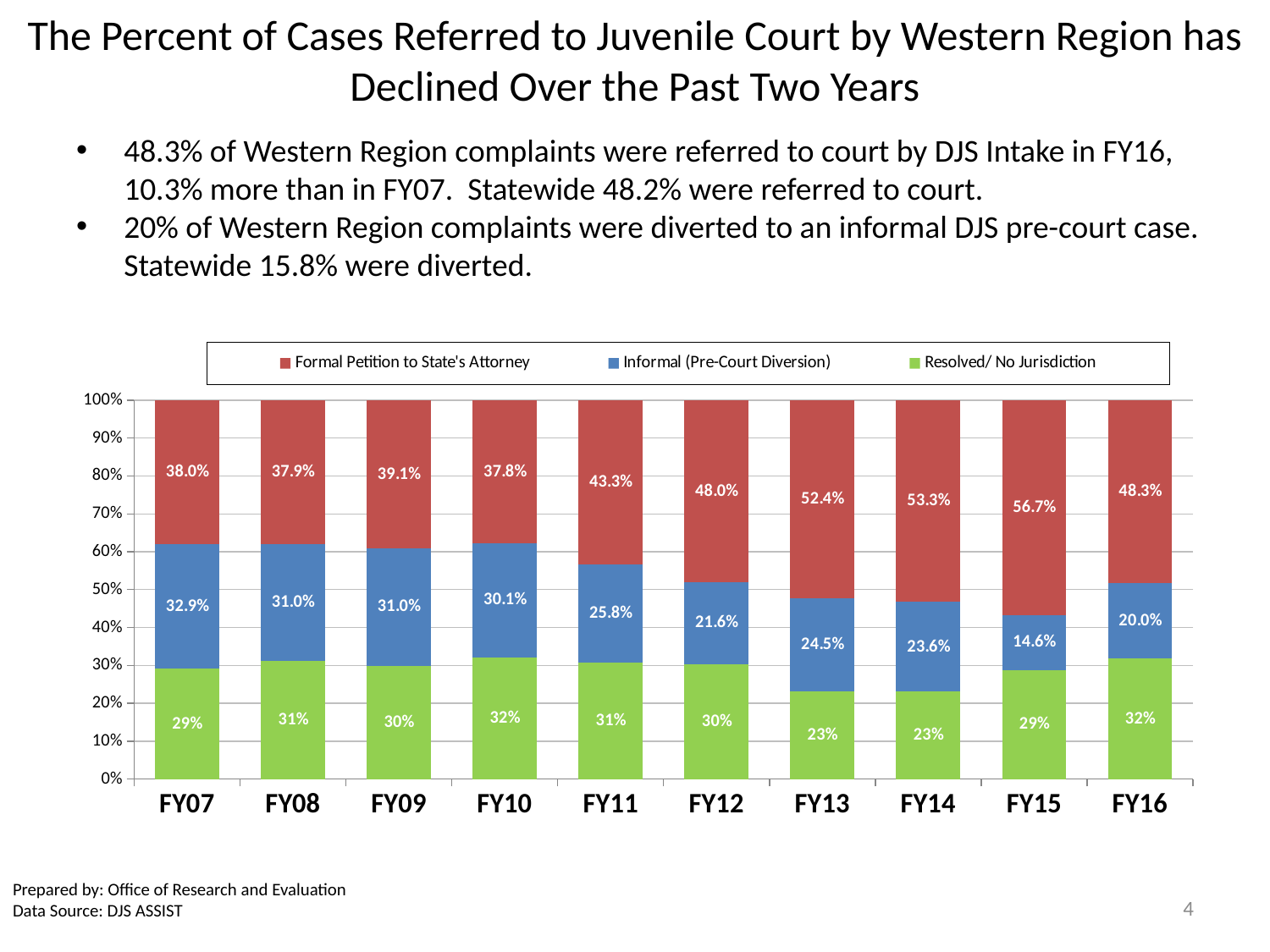
Does the Formal Petition to State's Attorney share rise or fall from FY10 to FY15? Rise In which fiscal year is the Formal Petition to State's Attorney share highest? FY15 In which fiscal year is the Informal (Pre-Court Diversion) share lowest? FY15 What kind of chart is shown on the slide? Stacked bar chart In which fiscal year is the Informal (Pre-Court Diversion) share highest? FY07 Which is larger in FY13: the Informal (Pre-Court Diversion) share or the Resolved/ No Jurisdiction share? Informal (Pre-Court Diversion) What is the Informal (Pre-Court Diversion) value for FY11? 25.8% What is the Resolved/ No Jurisdiction value for FY10? 32% How many series does the chart legend list? 3 How many fiscal years are shown on the x axis of the chart? 10 How much higher is the Formal Petition to State's Attorney share in FY16 than in FY07? 10.3% What percentage of Western Region cases were a Formal Petition to State's Attorney in FY15? 56.7%